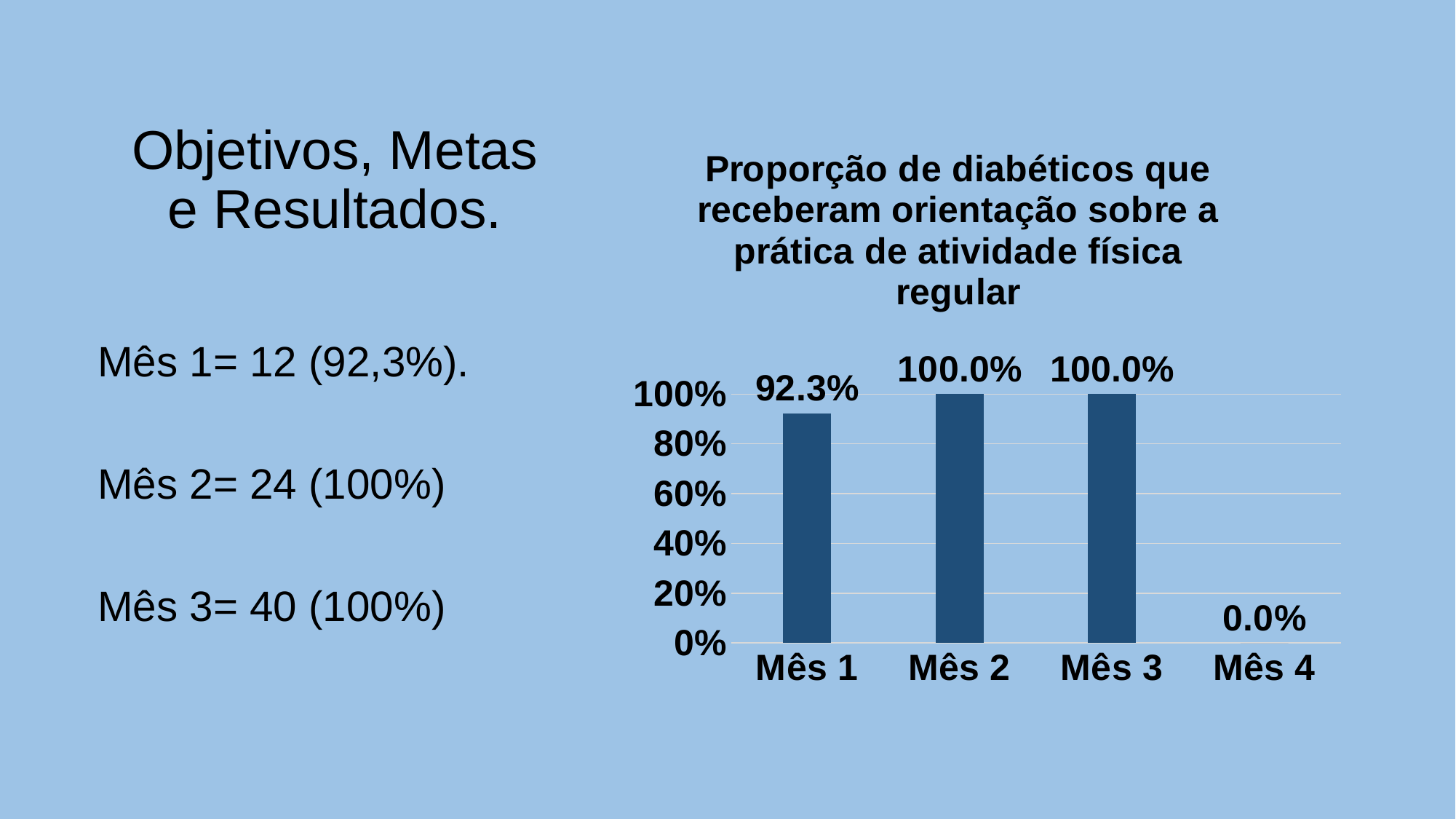
What kind of chart is shown? bar chart What is the value for Mês 1? 92.3% What is the title of the chart? Proporção de diabéticos que receberam orientação sobre a prática de atividade física regular What is the difference between the values for Mês 2 and Mês 1? 7.7% Is the value for Mês 1 greater or less than 80%? greater How many categories are shown on the x axis? 4 What is the highest tick label on the vertical axis? 100% Which is larger, the value for Mês 1 or the value for Mês 3? Mês 3 Do the values rise or fall from Mês 1 to Mês 2? rise What is the value for Mês 4? 0.0% What is the value for Mês 2? 100.0% Which category has the lowest value? Mês 4